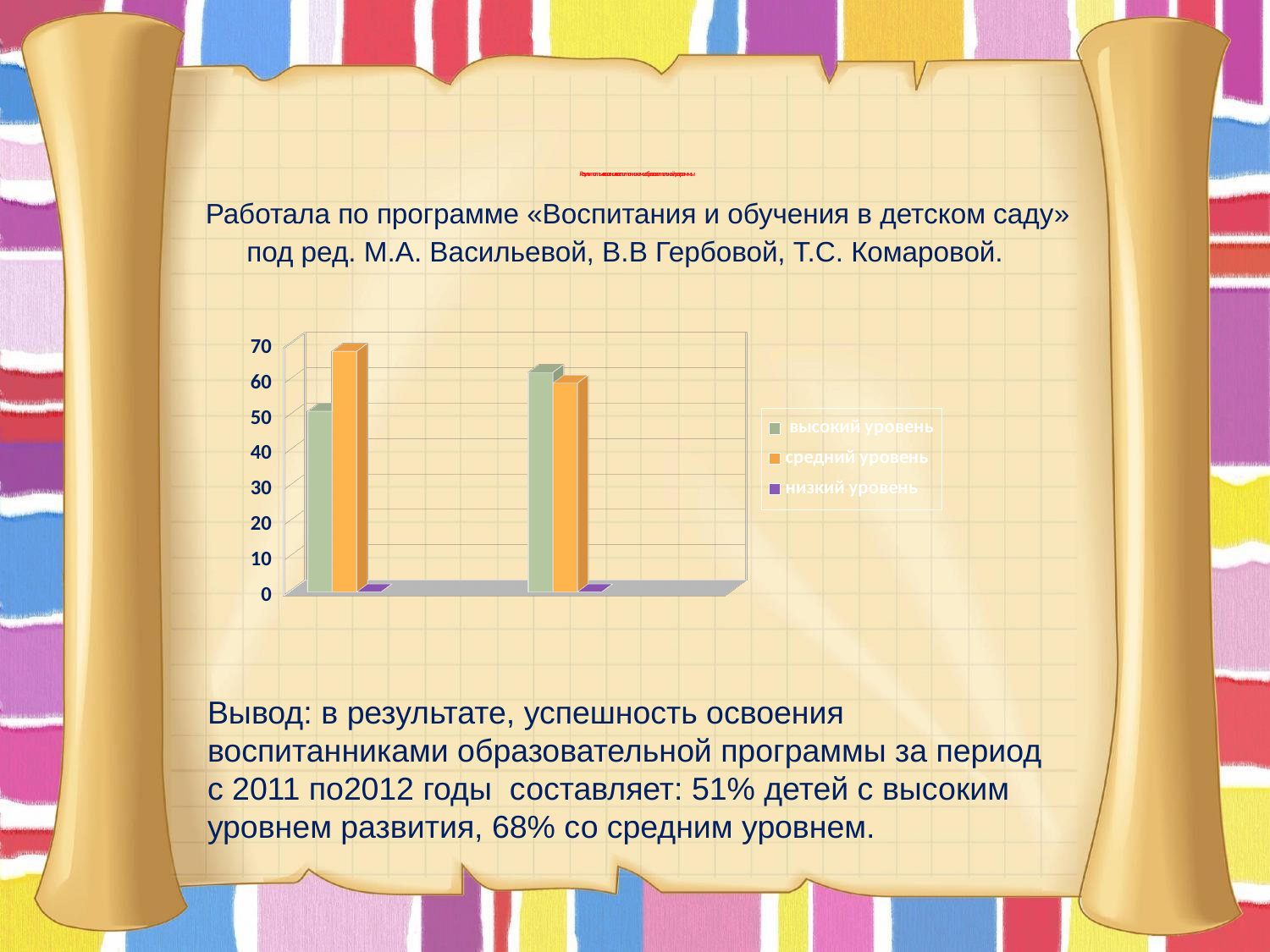
In the left group of bars, which is larger: высокий уровень or средний уровень? средний уровень How many series does the chart legend list? 3 In the left group of bars, is the value for низкий уровень greater or less than 10? less Which series is shown in purple in the chart legend? низкий уровень How many groups of bars are plotted in the chart? 2 Which series has the lowest value in the right group of bars? низкий уровень Which series is shown in orange in the chart legend? средний уровень Does the value for высокий уровень rise or fall from the left group to the right group? rise What kind of chart is shown on the slide? bar chart In the left group of bars, is the value for высокий уровень greater or less than 60? less In the right group of bars, is the value for высокий уровень greater or less than 50? greater